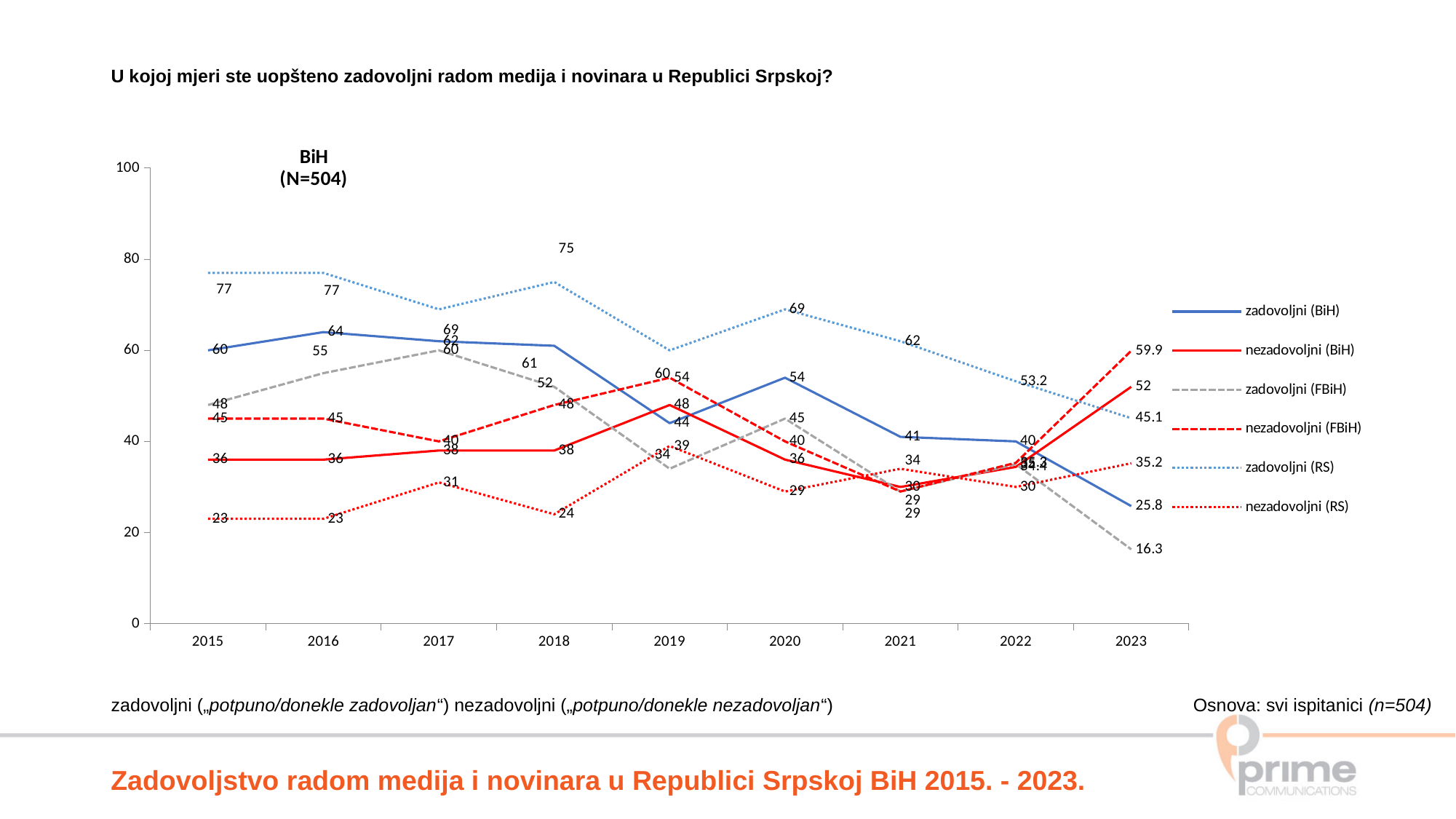
What is the difference between nezadovoljni (BiH) and zadovoljni (BiH) in 2023? 26.2 What is the value for zadovoljni (RS) in 2023? 45.1 How many years are shown on the x axis? 9 What is the value for zadovoljni (RS) in 2022? 53.2 Which series has the highest value in 2023? nezadovoljni (FBiH) What kind of chart is shown on the slide? line chart Does the zadovoljni (RS) series rise or fall from 2015 to 2023? fall How many series does the legend list? 6 What is the value for zadovoljni (RS) in 2015? 77 What is the value for zadovoljni (FBiH) in 2023? 16.3 What is the value for nezadovoljni (FBiH) in 2023? 59.9 Which series has the lowest value in 2023? zadovoljni (FBiH)